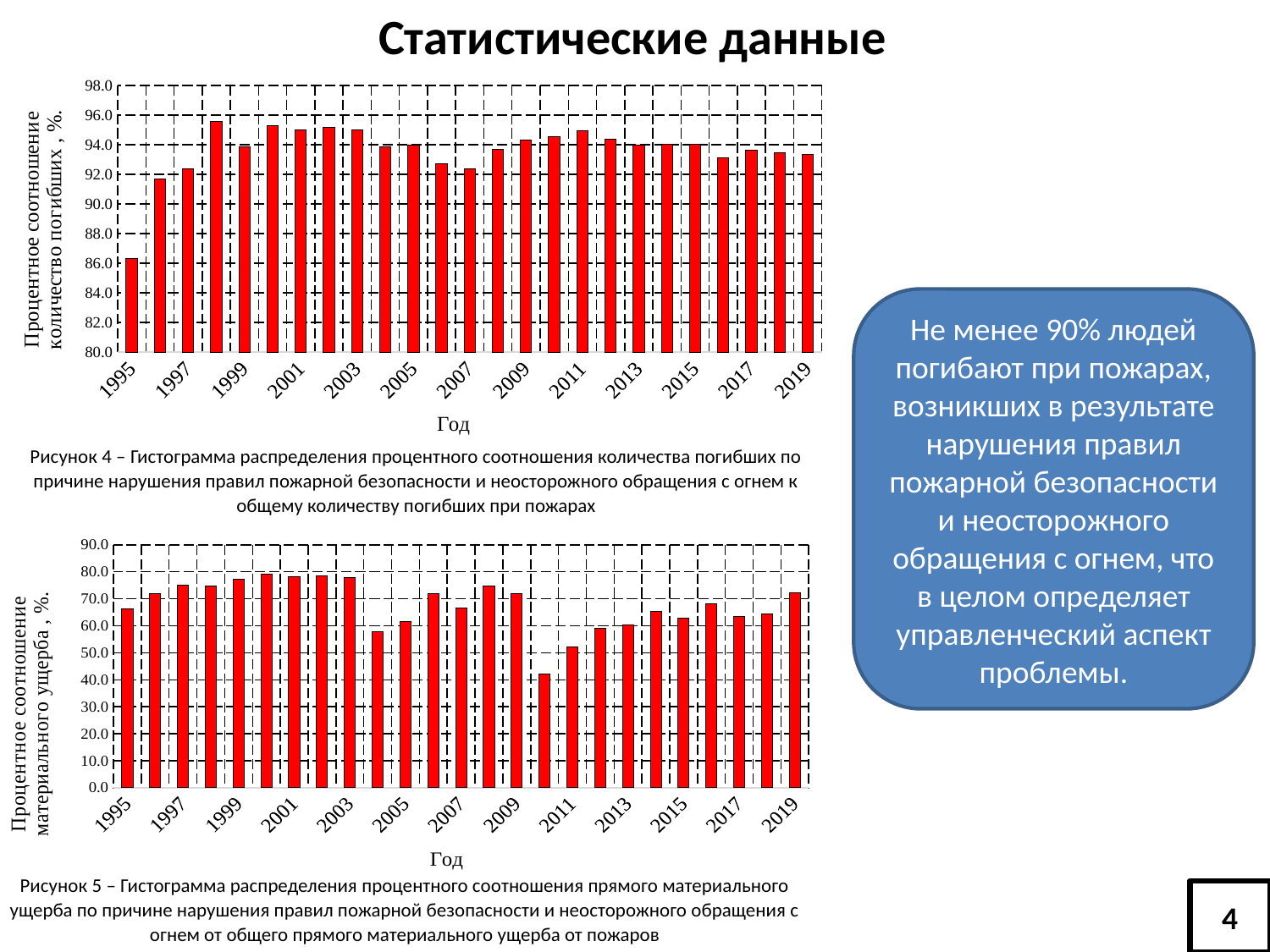
In the bottom chart (Рисунок 5), is the value for 2011 greater or less than 50.0? greater In the top chart (Рисунок 4), which year has the lowest value? 1995 What is the x-axis title of the bottom chart (Рисунок 5)? Год What kind of chart is Рисунок 4 (the top chart)? bar chart In the top chart (Рисунок 4), which year has the larger value, 1995 or 1999? 1999 In the bottom chart (Рисунок 5), which year has the lowest value? 2010 In the top chart (Рисунок 4), is the value for 1995 greater or less than 88.0? less How many bars (years) are plotted in the bottom chart (Рисунок 5)? 25 In the bottom chart (Рисунок 5), is the value for 2001 greater or less than 70.0? greater In the bottom chart (Рисунок 5), which year has the larger value, 2001 or 2011? 2001